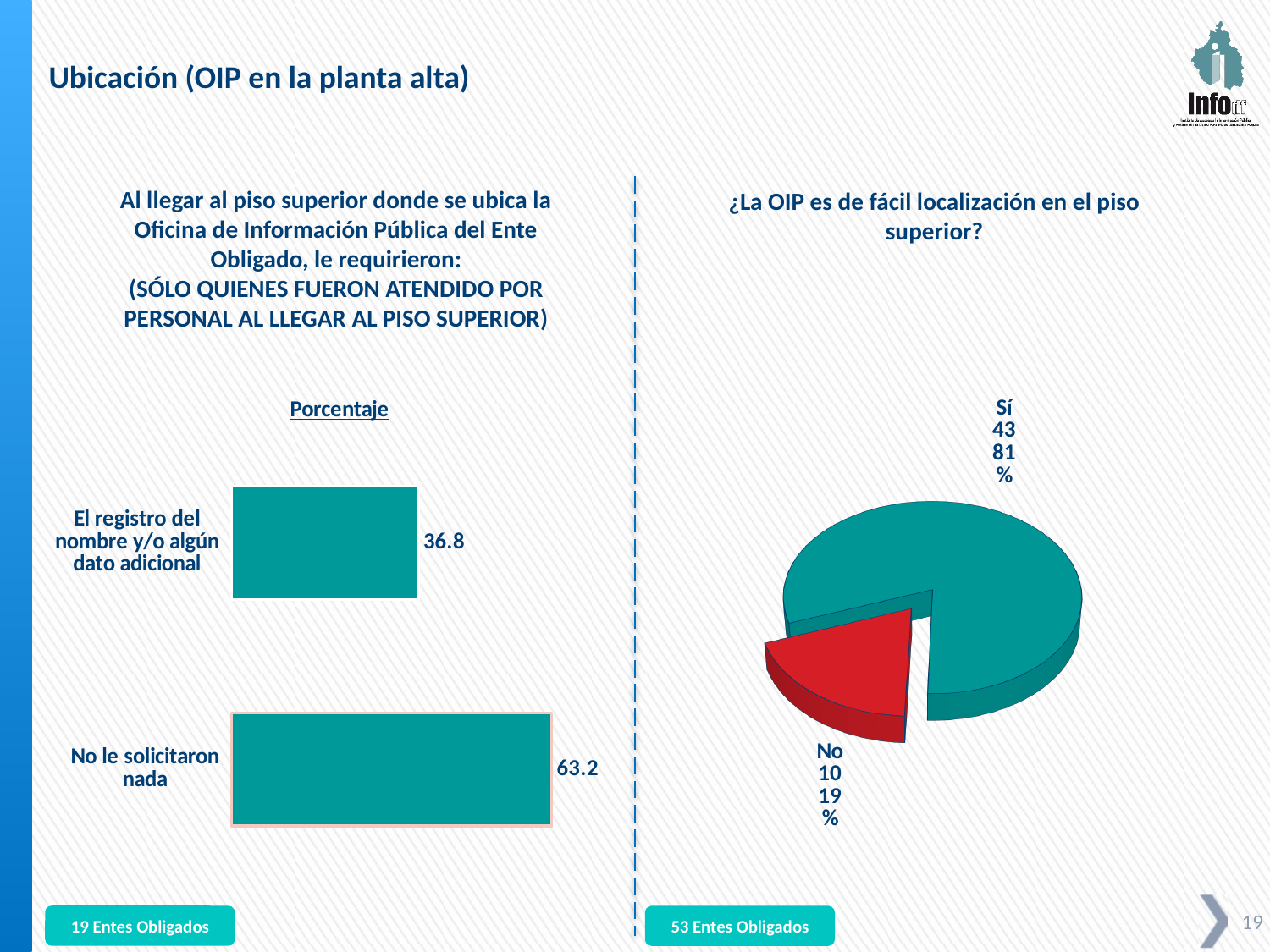
In the left bar chart, what is the value for 'No le solicitaron nada'? 63.2 What kind of chart is shown on the right side of the slide? Pie chart In the left bar chart, which category has the lowest value? El registro del nombre y/o algún dato adicional In the pie chart titled '¿La OIP es de fácil localización en el piso superior?', what percentage share does the 'Sí' slice have? 81% In the left bar chart, what is the value for 'El registro del nombre y/o algún dato adicional'? 36.8 In the pie chart titled '¿La OIP es de fácil localización en el piso superior?', which slice is larger, 'Sí' or 'No'? Sí In the left bar chart, which category has the highest value? No le solicitaron nada In the pie chart titled '¿La OIP es de fácil localización en el piso superior?', what is the count shown for 'No'? 10 In the left bar chart, how many categories are shown? 2 In the left bar chart, what is the difference between the values for 'No le solicitaron nada' and 'El registro del nombre y/o algún dato adicional'? 26.4 In the pie chart titled '¿La OIP es de fácil localización en el piso superior?', what colour is the 'No' slice? Red What kind of chart is shown on the left side of the slide? Bar chart